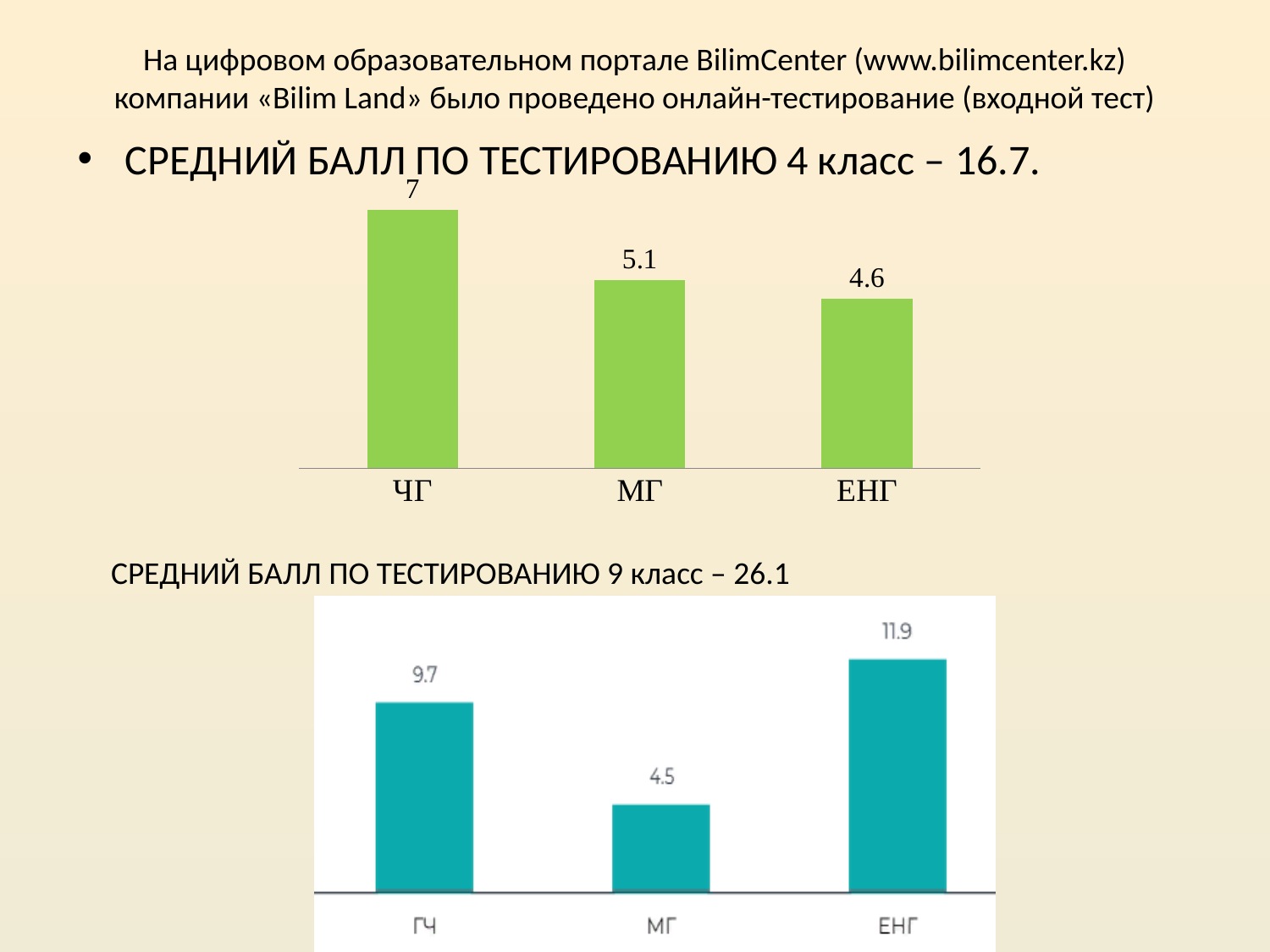
What type of chart is the bottom chart (9 класс)? bar chart In the bottom chart (9 класс), what is the value for МГ? 4.5 In the top chart (4 класс), what is the value for МГ? 5.1 In the top chart (4 класс), what is the difference between the values for ЧГ and ЕНГ? 2.4 In the bottom chart (9 класс), which is larger, the value for ГЧ or the value for МГ? ГЧ In the top chart (4 класс), do the values rise or fall from left to right? fall In the top chart (4 класс), what is the value for ЧГ? 7 In the bottom chart (9 класс), what is the difference between the values for ЕНГ and ГЧ? 2.2 In the bottom chart (9 класс), what is the value for ЕНГ? 11.9 In the top chart (4 класс), which category has the lowest value? ЕНГ In the bottom chart (9 класс), which category has the highest value? ЕНГ How many categories are shown in the top chart (4 класс)? 3